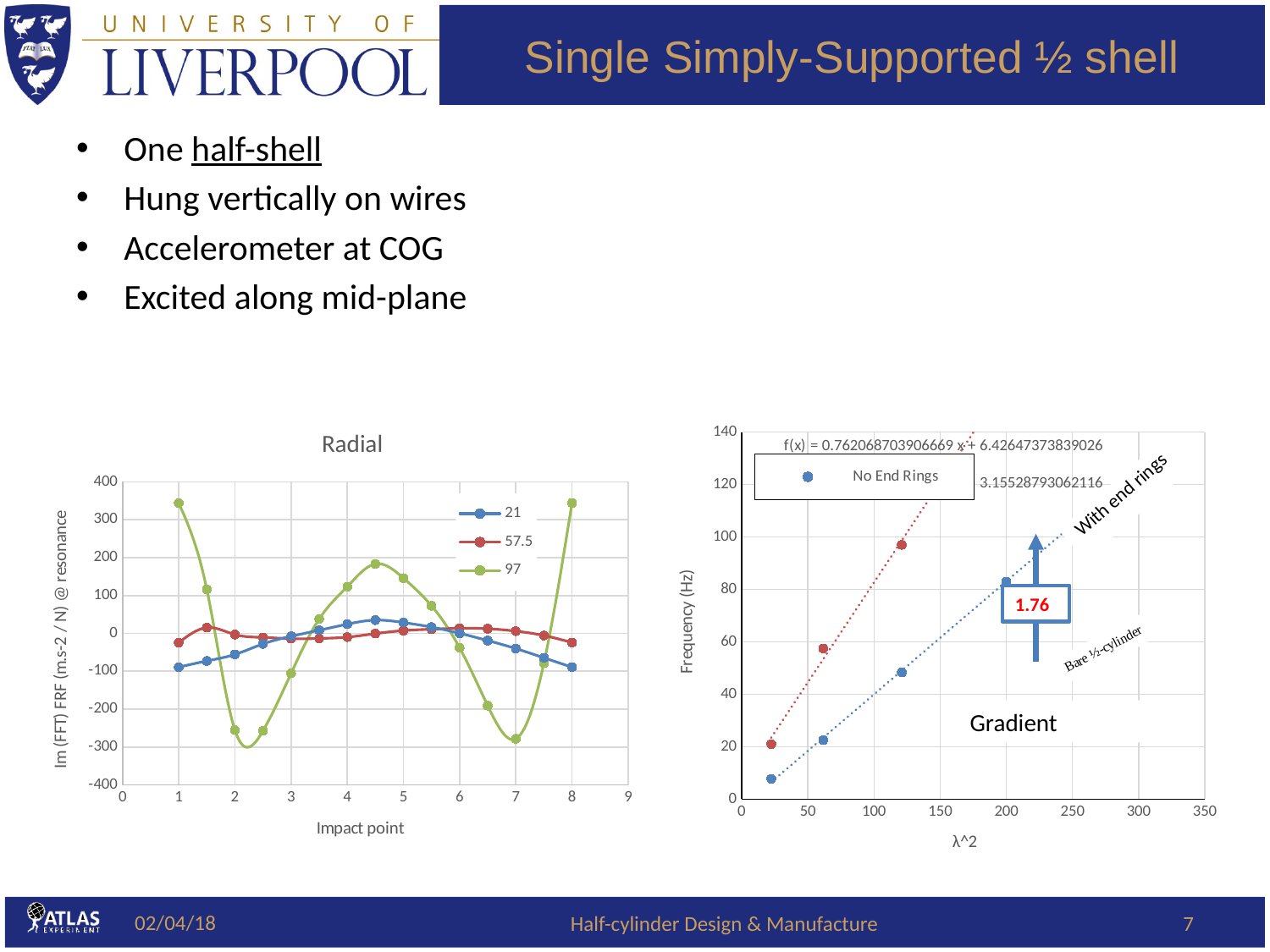
What series name does the legend of the right-hand chart show? No End Rings In the right-hand chart, is the blue point at λ^2 of about 200 greater or less than 60 Hz? greater In the Radial chart, is the value of series 21 at impact point 1 greater or less than -50? less What are the legend entries of the Radial chart? 21, 57.5, 97 How many series does the legend of the Radial chart list? 3 In the Radial chart, does series 21 rise or fall from impact point 1 to impact point 4? rises In the right-hand chart, is the red point at λ^2 of about 120 greater or less than 80 Hz? greater What kind of chart is the Radial chart on the left? line chart In the right-hand chart, does frequency rise or fall as λ^2 increases? rises What kind of chart is the Frequency (Hz) versus λ^2 chart on the right? scatter chart